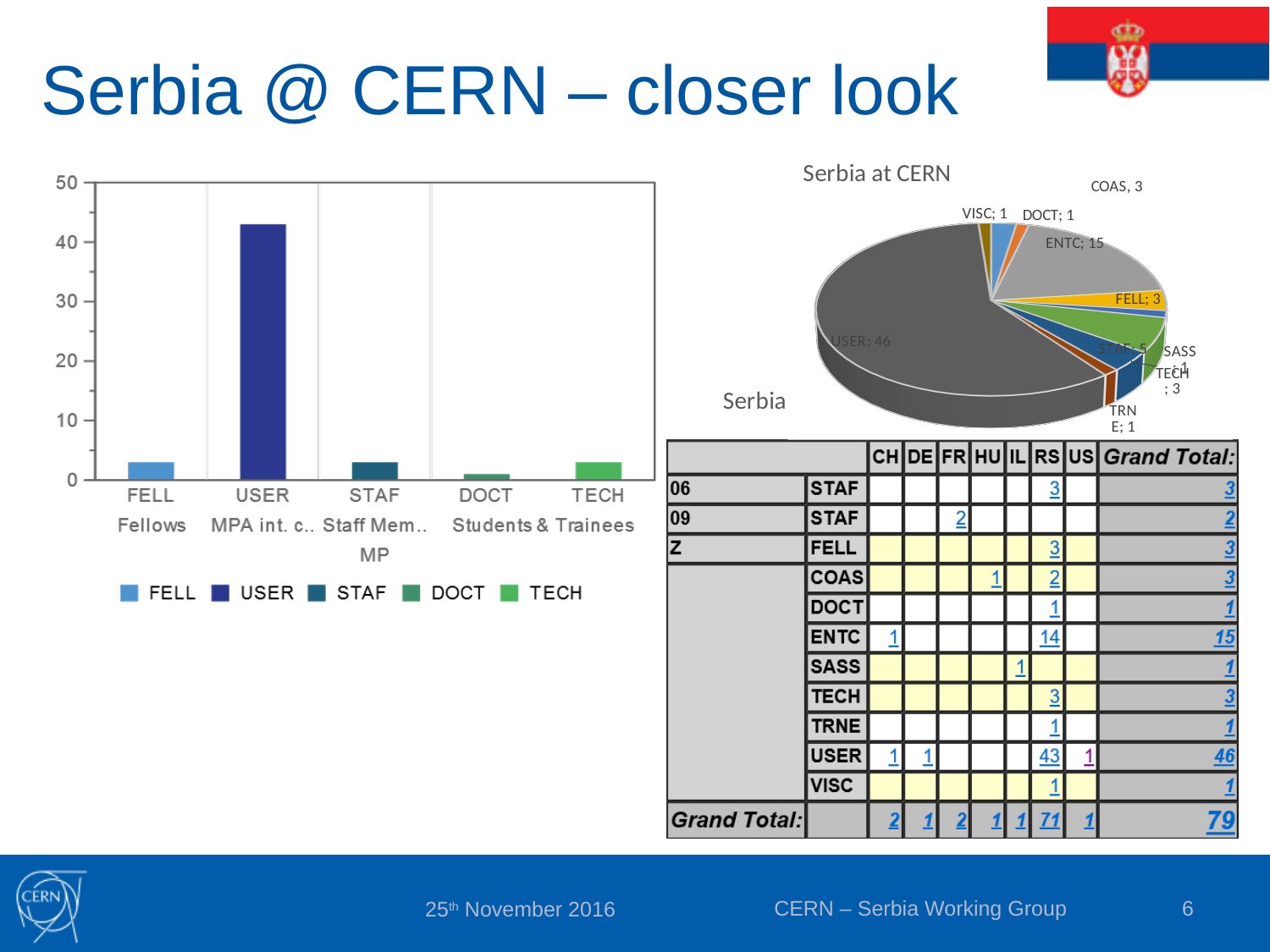
In the 'Serbia at CERN' pie chart, what is the value for ENTC? 15 In the 'Serbia at CERN' pie chart, which is larger, FELL or STAF? STAF In the bar chart on the left, which category has the lowest value? DOCT In the 'Serbia at CERN' pie chart, what is the value for USER? 46 In the bar chart on the left, is the value for FELL greater or less than 10? less In the bar chart on the left, is the value for USER greater or less than 40? greater In the bar chart on the left, which category has the highest value? USER How many entries does the legend of the bar chart on the left list? 5 How many categories are shown in the bar chart on the left? 5 In the 'Serbia at CERN' pie chart, what is the difference between the USER and ENTC values? 31 What type of chart is the chart on the left of the slide? bar chart In the 'Serbia at CERN' pie chart, what is the value for STAF? 5